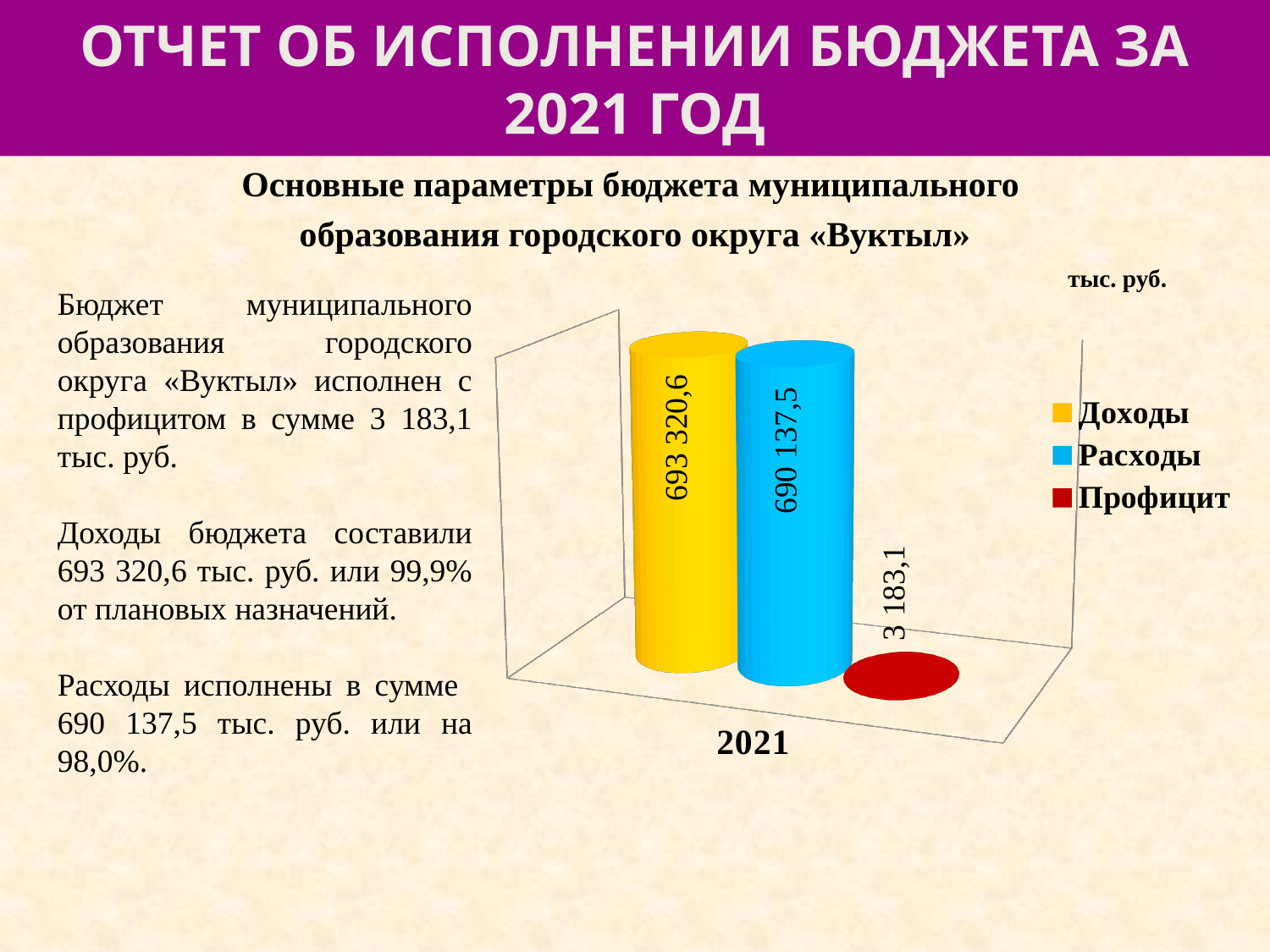
How many series does the chart legend list? 3 What unit is indicated for the values in the chart? тыс. руб. What is the difference between Доходы and Расходы in the chart? 3 183,1 How many categories are shown on the x axis of the chart? 1 What kind of chart is shown on the slide? bar chart What is the value for Профицит in the chart? 3 183,1 Which series has the highest value in the chart? Доходы Which series has the lowest value in the chart? Профицит What is the value for Расходы in the chart? 690 137,5 Which is larger in the chart, Доходы or Расходы? Доходы What is the value for Доходы in the chart? 693 320,6 What year is shown as the category on the x axis of the chart? 2021